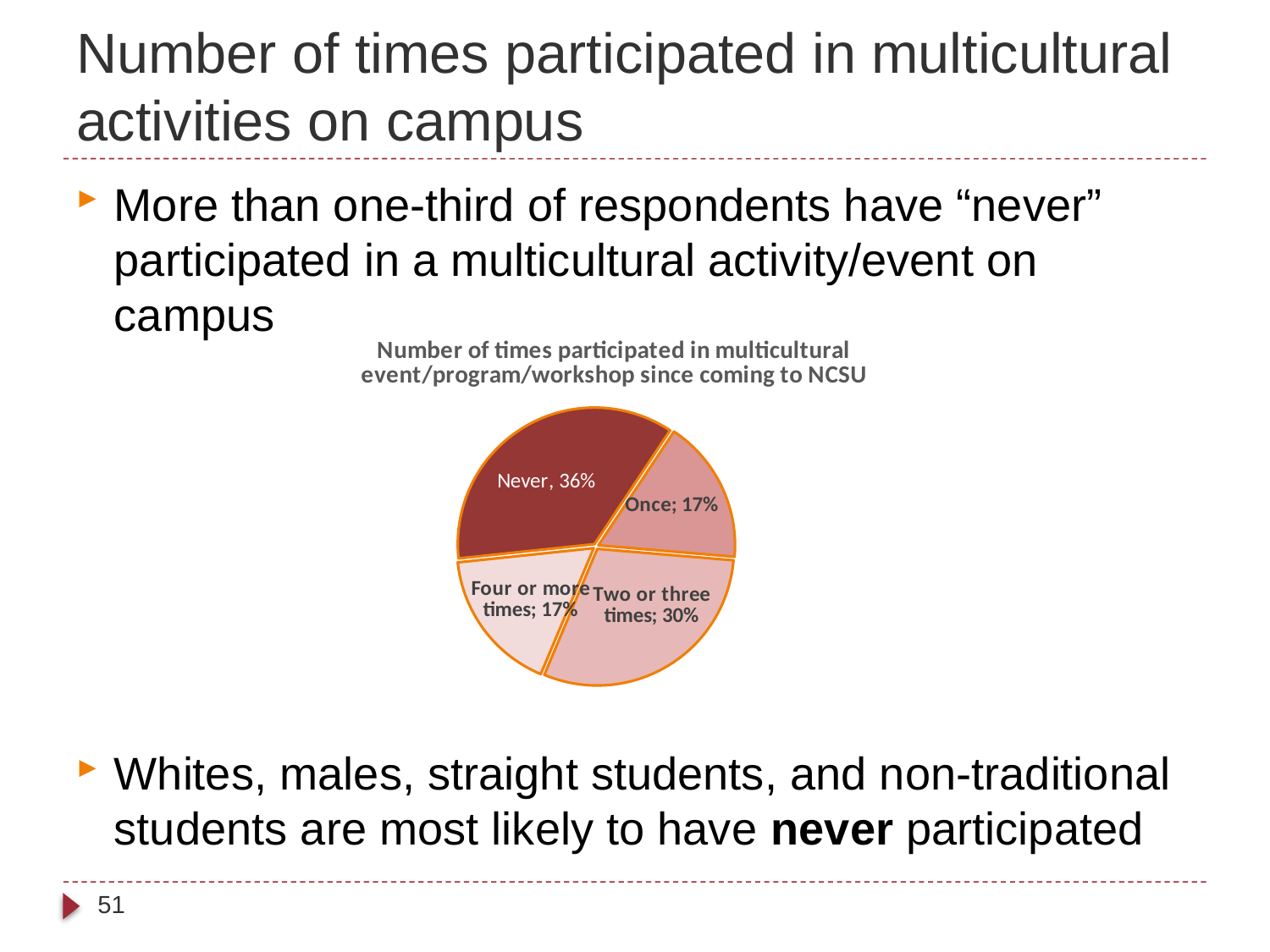
Which is larger, the share for "Never" or the share for "Once"? Never What is the difference between the "Never" share and the "Two or three times" share? 6% What is the difference between the "Two or three times" share and the "Once" share? 13% Which slice of the pie is coloured dark red? Never What kind of chart is shown on the slide? pie chart What share of respondents answered "Once"? 17% What share of respondents answered "Two or three times"? 30% What share of respondents answered "Four or more times"? 17% How many slices does the pie chart have? 4 What share of respondents answered "Never"? 36% Which category has the largest slice of the pie? Never What is the chart's title? Number of times participated in multicultural event/program/workshop since coming to NCSU